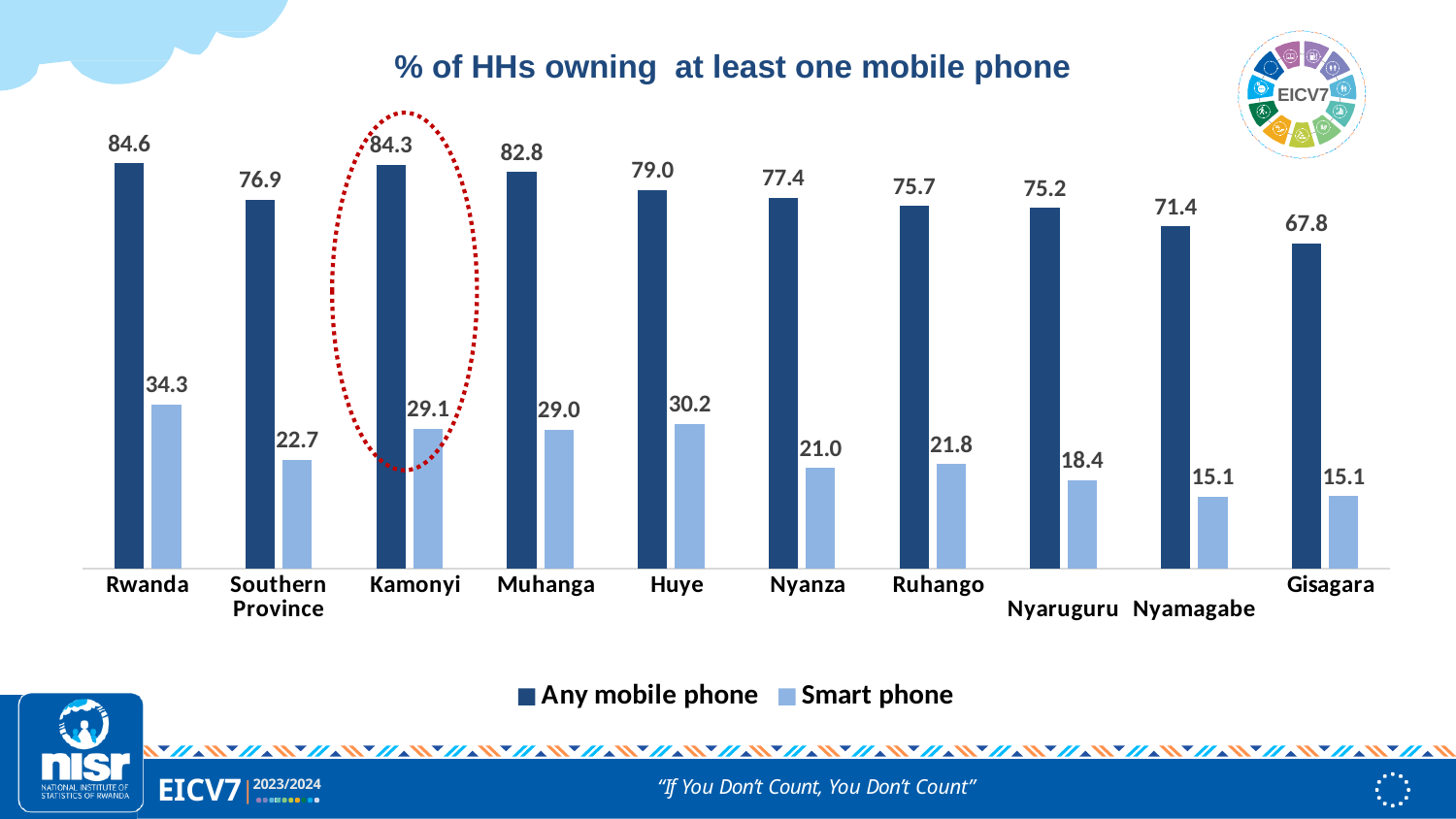
How many categories are shown on the x axis? 10 What is the Any mobile phone value for Rwanda? 84.6 What is the Smart phone value for Kamonyi? 29.1 What is the Any mobile phone value for Nyaruguru? 75.2 What is the Smart phone value for Southern Province? 22.7 Which category is highlighted with a red dotted circle? Kamonyi What kind of chart is this? Bar chart What is the difference between the Any mobile phone and Smart phone values for Kamonyi? 55.2 Which category has the highest Smart phone value? Rwanda Which has the higher Any mobile phone value, Huye or Nyanza? Huye How many series does the legend list? 2 Which category has the lowest Any mobile phone value? Gisagara